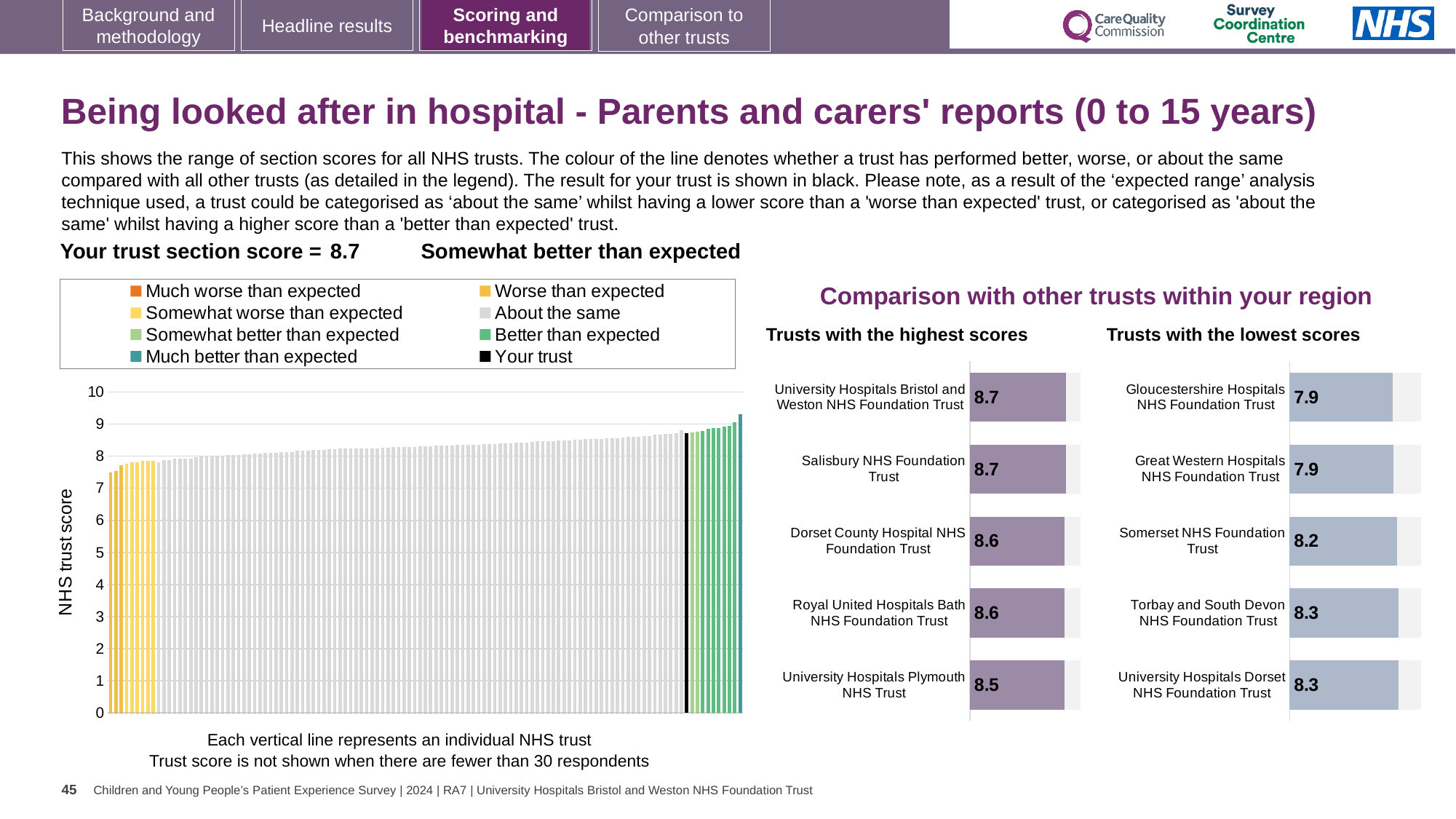
In the 'Trusts with the highest scores' chart, which trust has the lowest score? University Hospitals Plymouth NHS Trust In the 'Trusts with the lowest scores' chart, what is the difference between the score for Torbay and South Devon NHS Foundation Trust and the score for Great Western Hospitals NHS Foundation Trust? 0.4 In the 'Trusts with the highest scores' chart, what is the difference between the score for Salisbury NHS Foundation Trust and the score for University Hospitals Plymouth NHS Trust? 0.2 In the 'Trusts with the highest scores' chart, what is the score for Dorset County Hospital NHS Foundation Trust? 8.6 In the large 'NHS trust score' chart on the left, is the value for the black 'Your trust' bar greater or less than 8? greater How many entries does the legend of the large 'NHS trust score' chart on the left list? 8 How many trusts are shown in the 'Trusts with the highest scores' chart? 5 In the 'Trusts with the highest scores' chart, what is the score for University Hospitals Plymouth NHS Trust? 8.5 What kind of chart is the large 'NHS trust score' chart on the left? Bar chart In the 'Trusts with the lowest scores' chart, which has the larger score: Somerset NHS Foundation Trust or Torbay and South Devon NHS Foundation Trust? Torbay and South Devon NHS Foundation Trust In the 'Trusts with the lowest scores' chart, what is the score for Somerset NHS Foundation Trust? 8.2 In the 'Trusts with the lowest scores' chart, what is the score for Gloucestershire Hospitals NHS Foundation Trust? 7.9